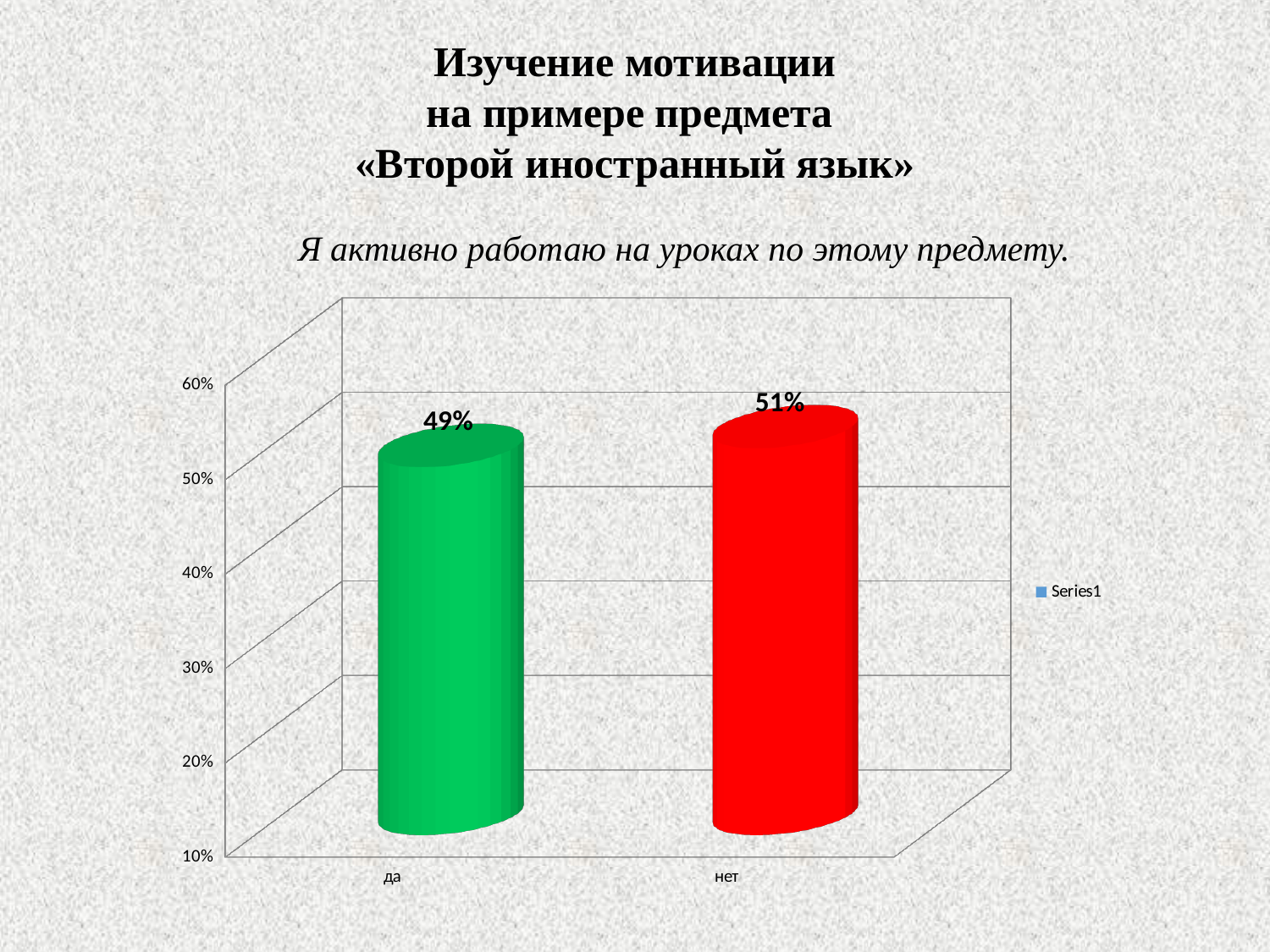
What kind of chart is shown on the slide? bar chart What is the difference between the values for "нет" and "да"? 2% What is the value for "да"? 49% What colour is the bar for "нет"? red Is the value for "нет" greater or less than 60%? less What is the value for "нет"? 51% Which category has the highest value? нет Which category has the lowest value? да Which is larger, the value for "да" or the value for "нет"? нет How many series does the legend list? 1 How many categories are shown on the x axis? 2 Is the value for "да" greater or less than 40%? greater